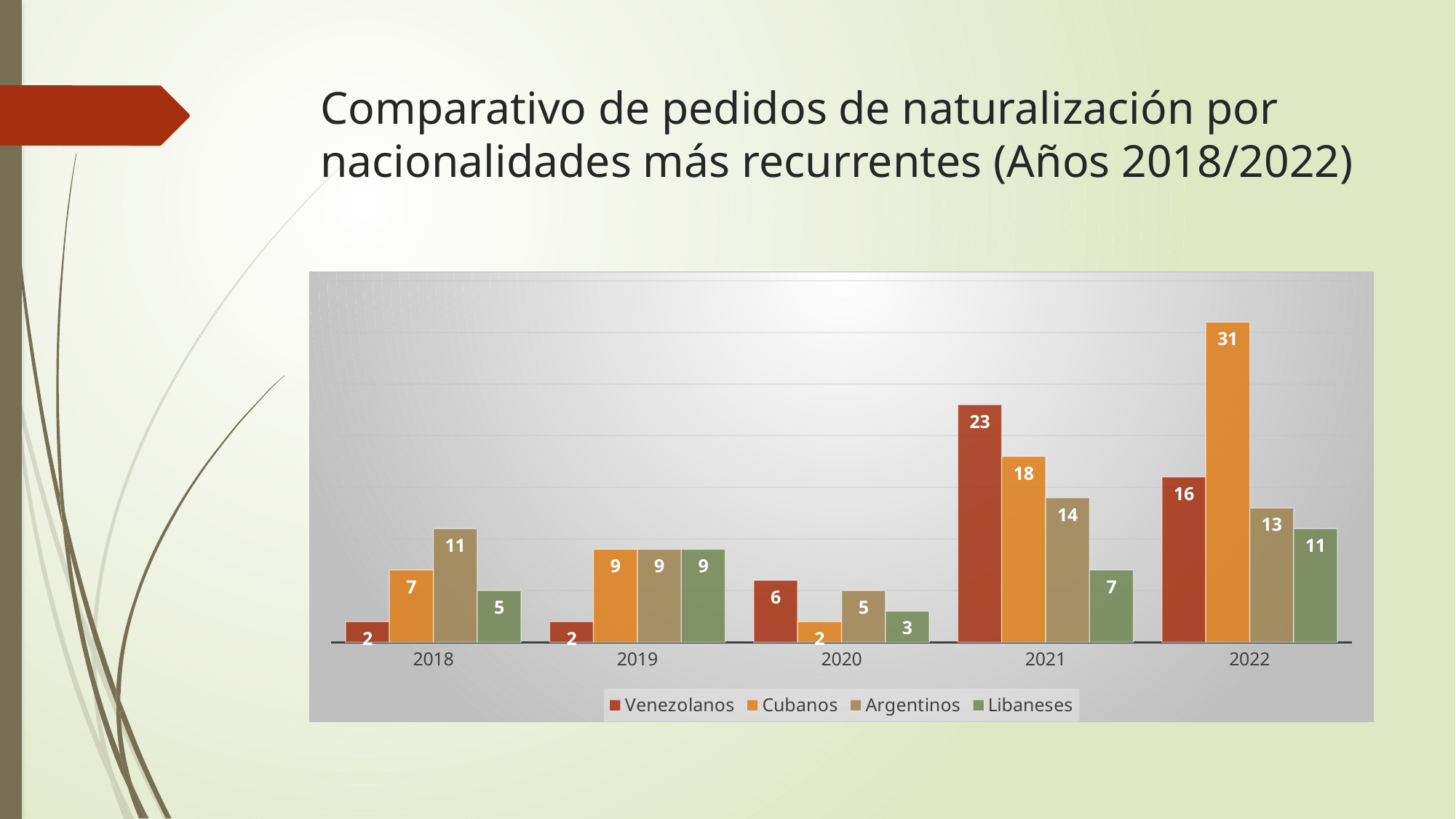
What kind of chart is shown on the slide? Bar chart How many series does the legend list? 4 What is the value for Libaneses in 2020? 3 What is the value for Cubanos in 2022? 31 What is the value for Venezolanos in 2021? 23 How many years are shown on the x axis? 5 Which is larger in 2021, Venezolanos or Cubanos? Venezolanos Which series is shown in orange in the legend? Cubanos In which year is the Cubanos value highest? 2022 What is the value for Argentinos in 2018? 11 In which year is the Libaneses value lowest? 2020 What is the difference between the Cubanos and Venezolanos values in 2022? 15